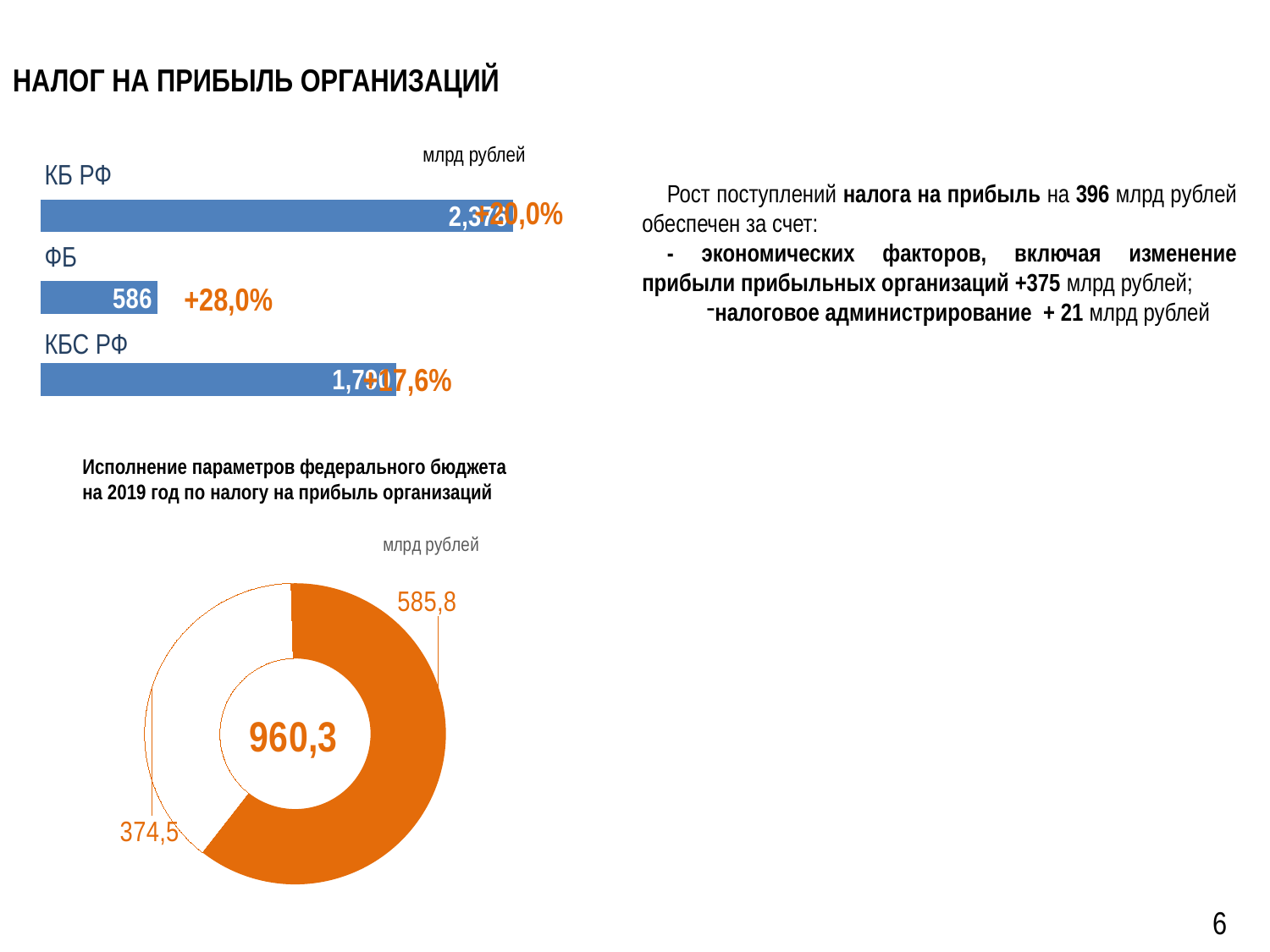
In the upper bar chart, what growth percentage is shown for КБ РФ? +20,0% In the upper bar chart, which category has the longest bar? КБ РФ In the lower donut chart, what is the difference between the two slice values 585,8 and 374,5? 211,3 In the upper bar chart, how many categories are shown? 3 In the upper bar chart, what growth percentage is shown for КБС РФ? +17,6% What kind of chart is the upper chart showing КБ РФ, ФБ and КБС РФ? bar chart In the lower donut chart, what value is shown in the centre? 960,3 In the upper bar chart, what is the value for ФБ? 586 In the upper bar chart, what growth percentage is shown next to ФБ? +28,0% What kind of chart is the lower chart titled 'Исполнение параметров федерального бюджета на 2019 год по налогу на прибыль организаций'? donut chart In the upper bar chart, which bar is longer: КБС РФ or ФБ? КБС РФ In the upper bar chart, which category has the shortest bar? ФБ